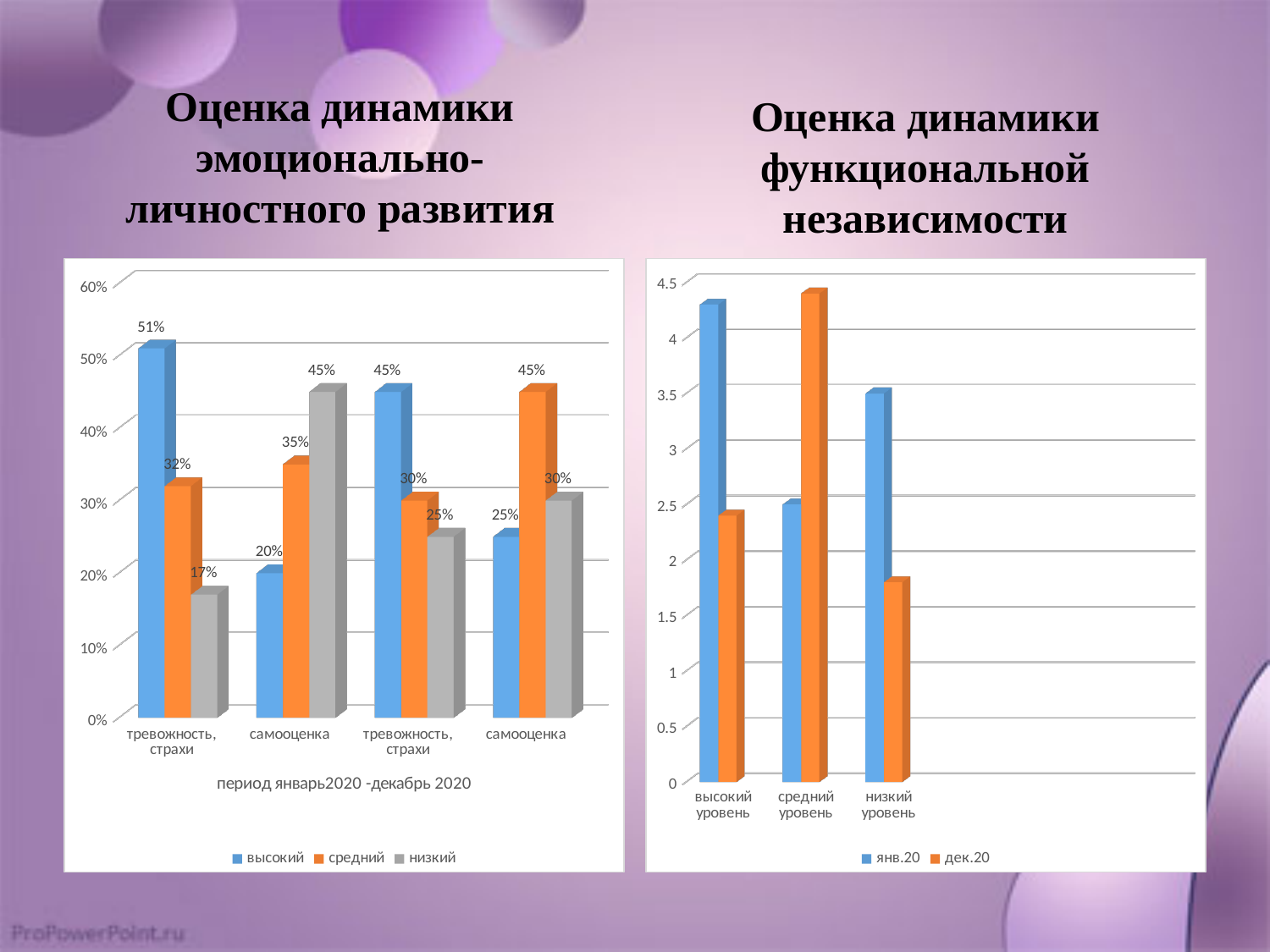
What kind of chart is the right chart (Оценка динамики функциональной независимости)? bar chart In the right chart (Оценка динамики функциональной независимости), which is larger for 'средний уровень': the янв.20 value or the дек.20 value? дек.20 In the left chart (Оценка динамики эмоционально-личностного развития), which is larger in the second 'тревожность, страхи' group (third group from the left): the высокий value or the средний value? высокий In the right chart (Оценка динамики функциональной независимости), is the янв.20 value for 'высокий уровень' greater or less than 4? greater In the left chart (Оценка динамики эмоционально-личностного развития), what is the value of the средний series for the rightmost 'самооценка' group? 45% In the left chart (Оценка динамики эмоционально-личностного развития), what is the value of the высокий series for the leftmost 'тревожность, страхи' group? 51% In the left chart (Оценка динамики эмоционально-личностного развития), what is the value of the низкий series for the first 'самооценка' group (second group from the left)? 45% In the left chart (Оценка динамики эмоционально-личностного развития), which series has the lowest value in the leftmost 'тревожность, страхи' group? низкий In the right chart (Оценка динамики функциональной независимости), is the дек.20 value for 'низкий уровень' greater or less than 2? less How many series does the legend of the left chart (Оценка динамики эмоционально-личностного развития) list? 3 In the left chart (Оценка динамики эмоционально-личностного развития), what is the difference between the высокий and низкий values in the leftmost 'тревожность, страхи' group? 34% How many category groups are shown on the x axis of the left chart (Оценка динамики эмоционально-личностного развития)? 4